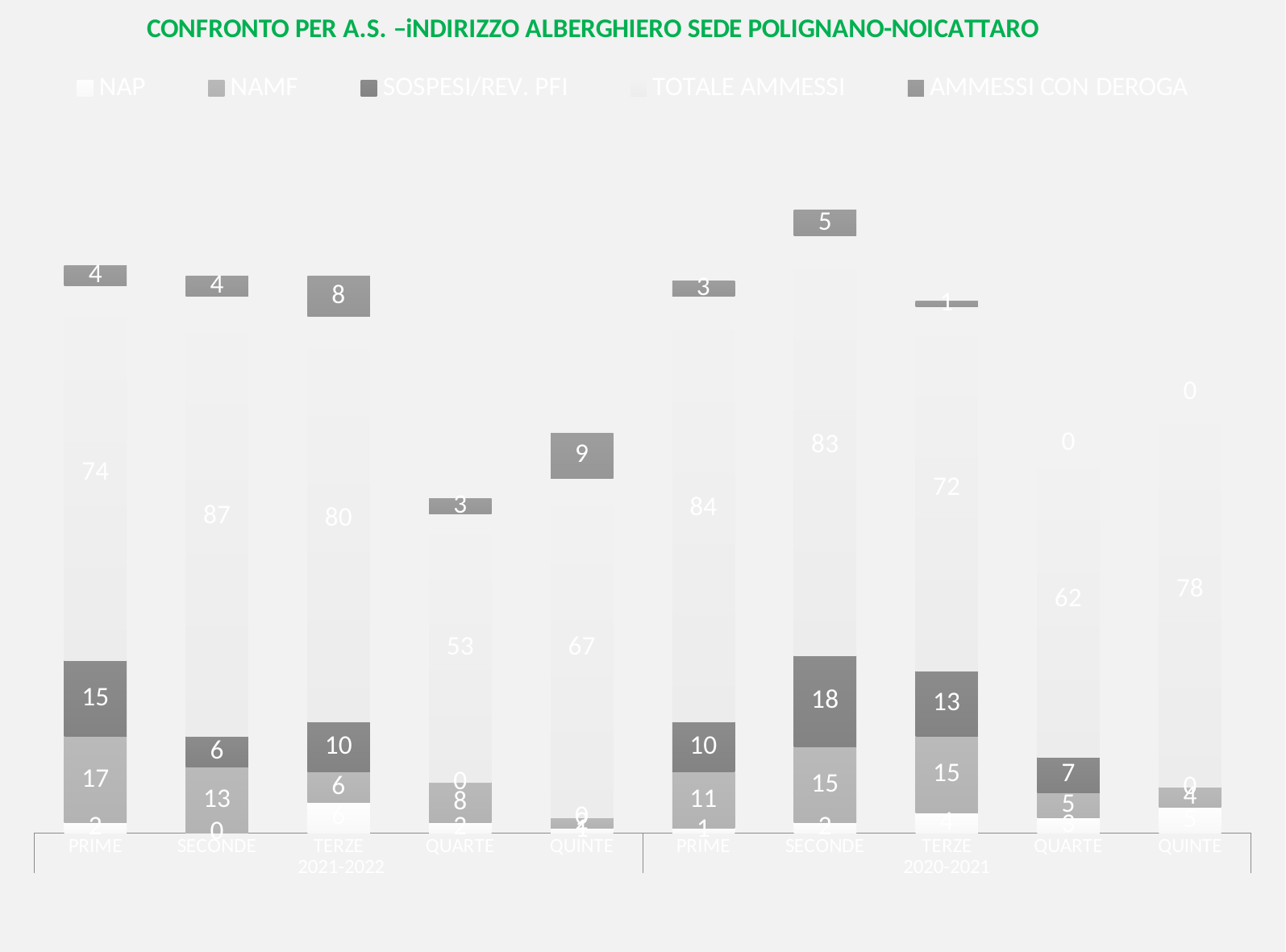
What is the AMMESSI CON DEROGA value for QUINTE in 2021-2022? 9 What is the SOSPESI/REV. PFI value for SECONDE in 2020-2021? 18 Which category has the lowest TOTALE AMMESSI value? QUARTE 2021-2022 How many series does the legend list? 5 Which category has the highest TOTALE AMMESSI value? SECONDE 2021-2022 Which is larger: the NAMF value for PRIME in 2021-2022 or for SECONDE in 2020-2021? PRIME 2021-2022 What is the difference between the SOSPESI/REV. PFI value for PRIME in 2021-2022 and PRIME in 2020-2021? 5 What is the TOTALE AMMESSI value for SECONDE in 2021-2022? 87 What kind of chart is shown on the slide? Stacked bar chart How many class categories are plotted along the x axis in total? 10 What is the TOTALE AMMESSI value for QUARTE in 2020-2021? 62 What is the title of the chart? CONFRONTO PER A.S. –iNDIRIZZO ALBERGHIERO SEDE POLIGNANO-NOICATTARO